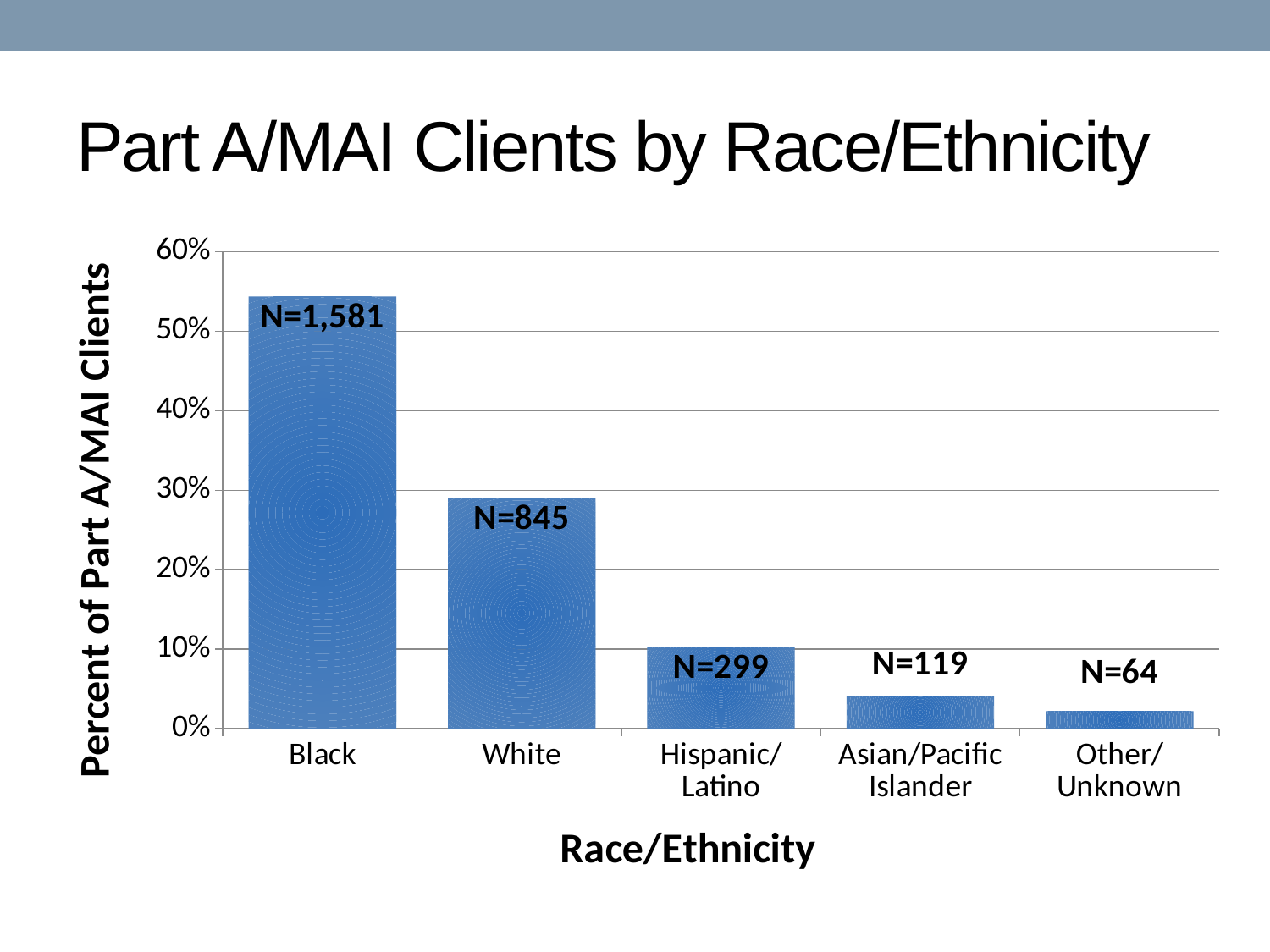
Which has a larger percent of Part A/MAI clients, White or Hispanic/Latino? White Which race/ethnicity category has the lowest percent of Part A/MAI clients? Other/Unknown Which race/ethnicity category has the highest percent of Part A/MAI clients? Black Is the percent of Part A/MAI clients for Black greater or less than 50%? greater Is the percent of Part A/MAI clients for White greater or less than 30%? less What is the N label shown on the bar for Other/Unknown? N=64 What type of chart is shown on the slide? Bar chart What is the N label shown on the bar for White? N=845 What is the N label shown on the bar for Black? N=1,581 What is the N label shown on the bar for Hispanic/Latino? N=299 How many race/ethnicity categories are shown on the x axis? 5 Is the percent of Part A/MAI clients for Asian/Pacific Islander greater or less than 10%? less